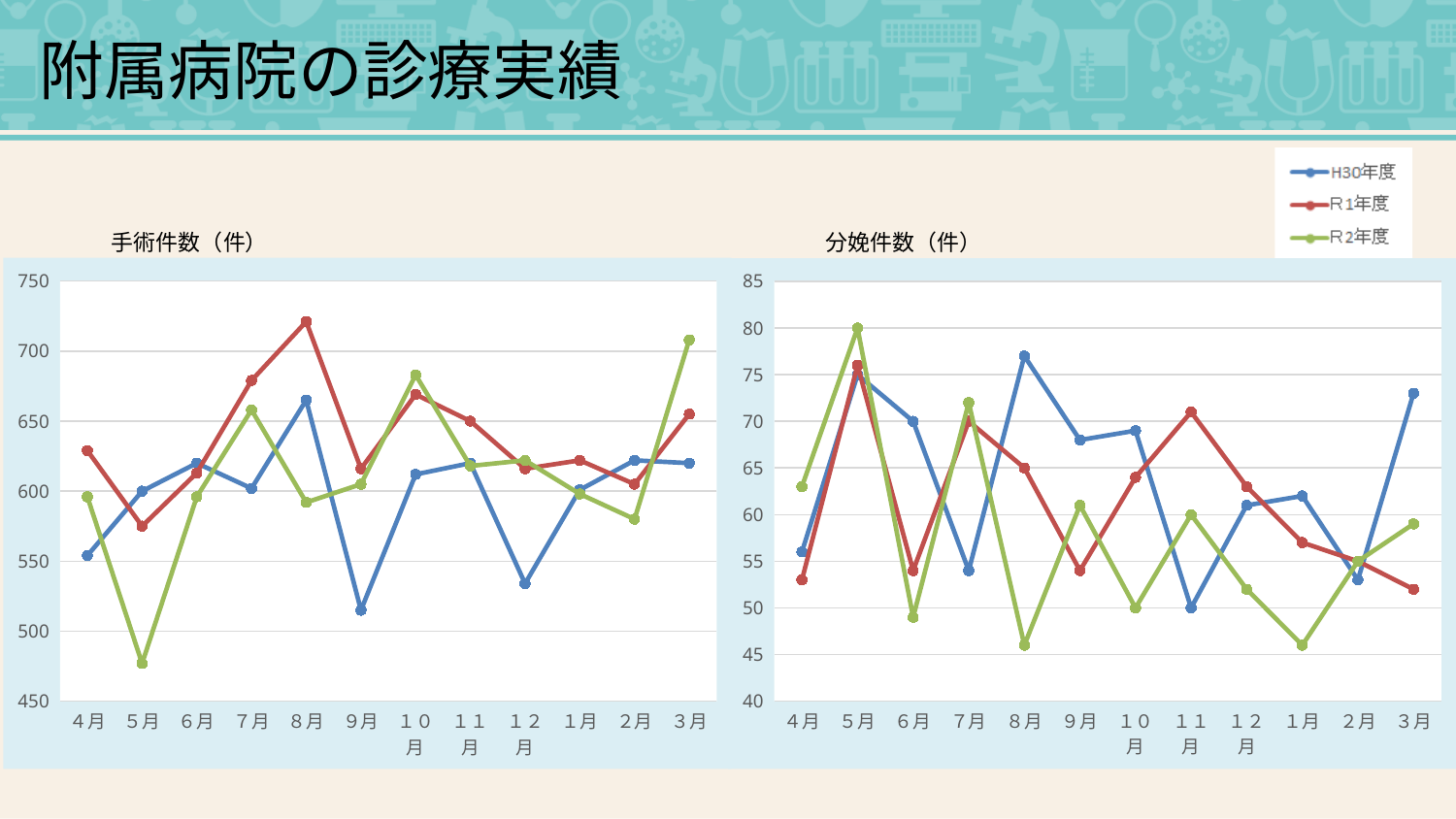
How many series does the legend list? 3 In the 分娩件数（件） chart, which month has the highest value for R2年度? 5月 Which colour is used for the R1年度 series? red What kind of chart is the 手術件数（件） chart on the left? line chart How many months are plotted along the x axis of the 分娩件数（件） chart? 12 In the 手術件数（件） chart, is the value for H30年度 in 9月 greater or less than 550? less In the 分娩件数（件） chart, is the value for H30年度 in 8月 greater or less than 75? greater In the 分娩件数（件） chart, which is larger in 8月: H30年度 or R2年度? H30年度 In the 手術件数（件） chart, which month has the highest value for R1年度? 8月 In the 分娩件数（件） chart, which month has the lowest value for H30年度? 11月 In the 手術件数（件） chart, is the value for R2年度 in 3月 greater or less than 700? greater In the 手術件数（件） chart, which month has the lowest value for R2年度? 5月